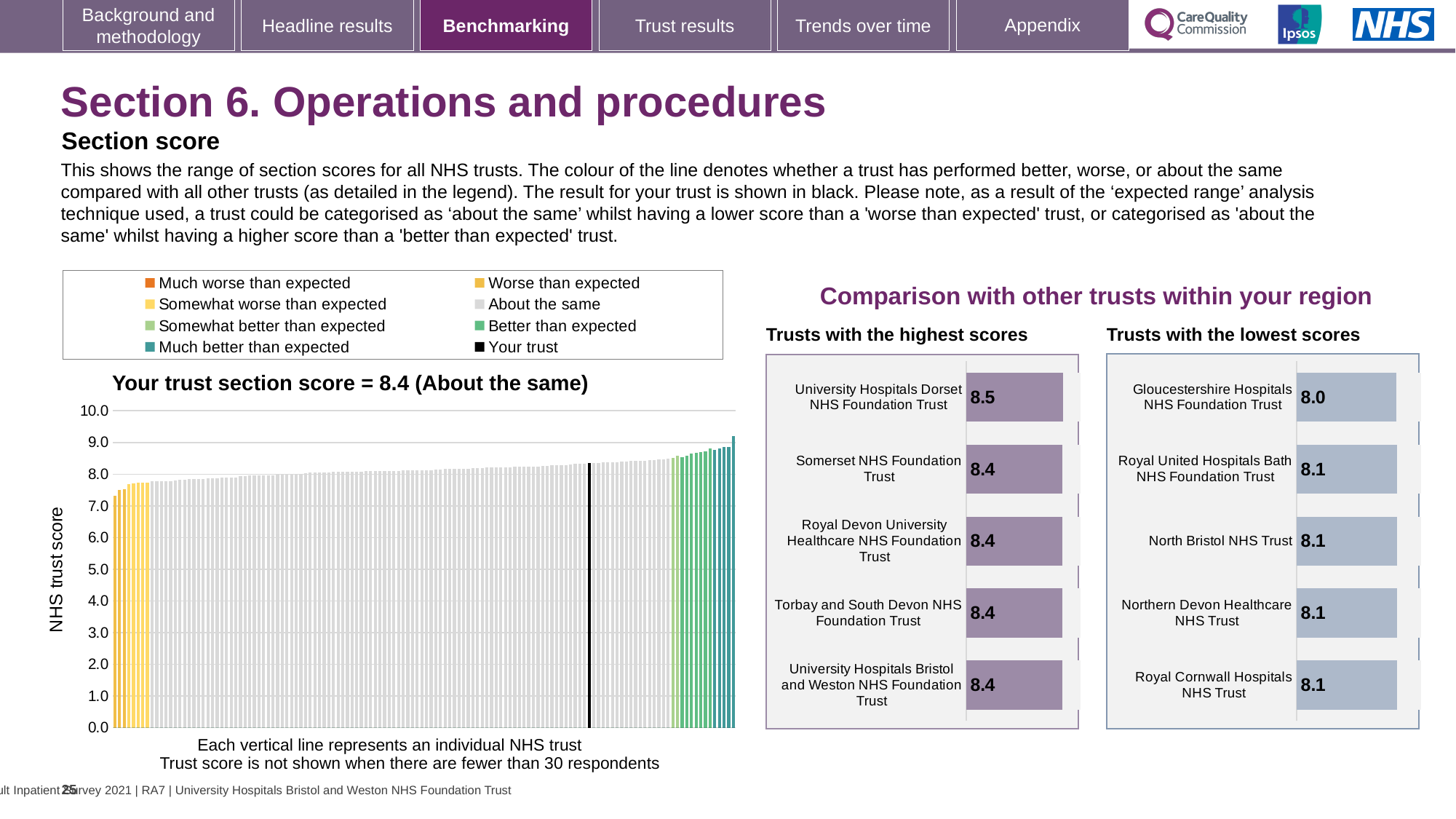
In the 'Trusts with the highest scores' chart, which trust has the highest score? University Hospitals Dorset NHS Foundation Trust In the 'Trusts with the highest scores' chart, what is the score for University Hospitals Dorset NHS Foundation Trust? 8.5 In the 'Trusts with the highest scores' chart, what is the difference between the scores of University Hospitals Dorset NHS Foundation Trust and Somerset NHS Foundation Trust? 0.1 How many trusts are listed in the 'Trusts with the highest scores' chart? 5 In the main 'Your trust section score' chart, do the bar values rise or fall from left to right? rise How many entries does the legend above the main 'Your trust section score' chart list? 8 In the 'Trusts with the lowest scores' chart, what is the score for Gloucestershire Hospitals NHS Foundation Trust? 8.0 In the main 'Your trust section score' chart, what is the section score for your trust? 8.4 In the 'Trusts with the lowest scores' chart, what is the score for Royal Cornwall Hospitals NHS Trust? 8.1 In the main 'Your trust section score' chart, is the value of the leftmost bar greater or less than 8.0? less Which is larger: the score for University Hospitals Dorset NHS Foundation Trust in the 'Trusts with the highest scores' chart, or the score for Gloucestershire Hospitals NHS Foundation Trust in the 'Trusts with the lowest scores' chart? University Hospitals Dorset NHS Foundation Trust In the 'Trusts with the lowest scores' chart, which trust has the lowest score? Gloucestershire Hospitals NHS Foundation Trust